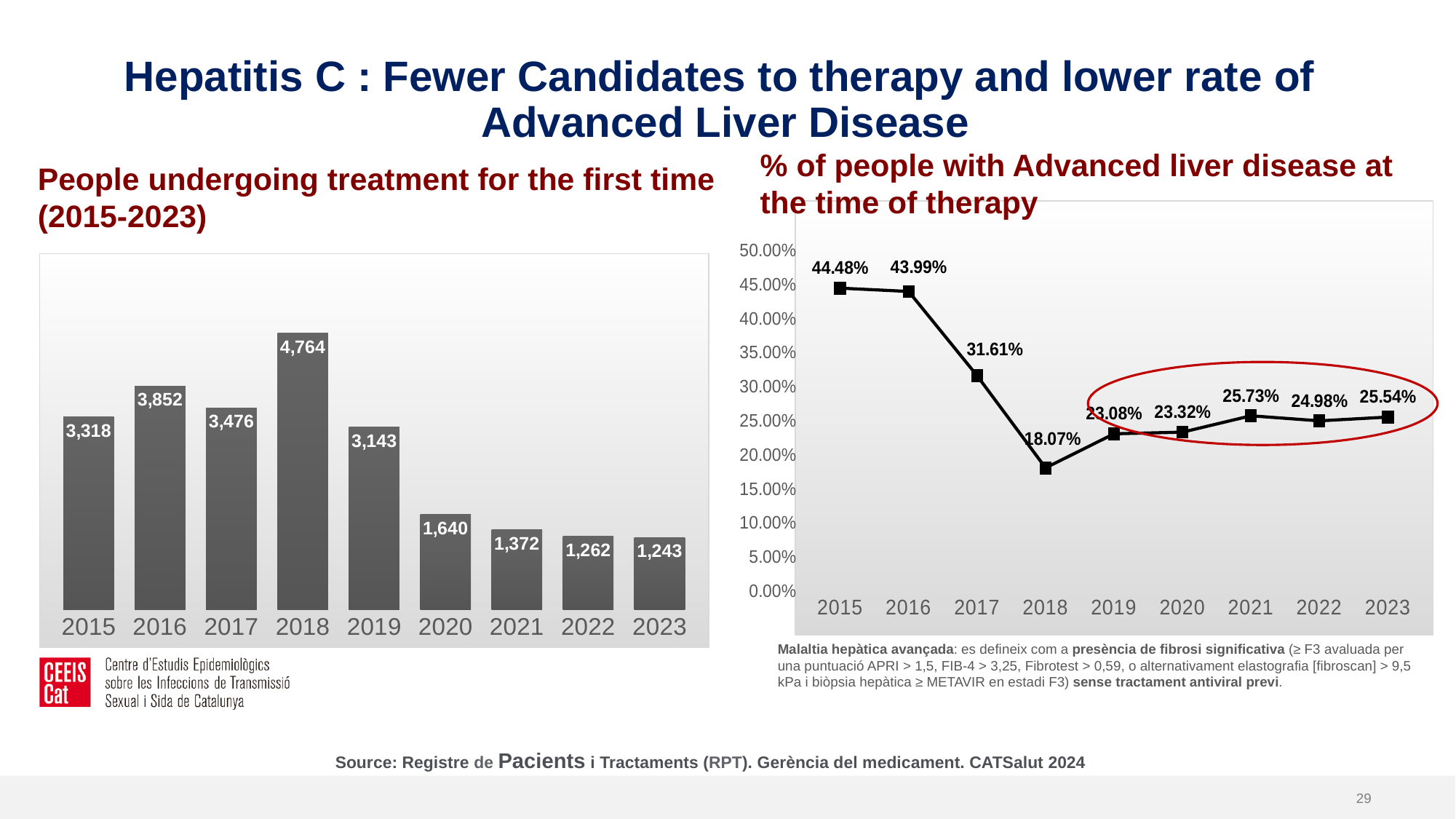
In the 'People undergoing treatment for the first time (2015-2023)' chart, which year has the highest value? 2018 In the '% of people with Advanced liver disease at the time of therapy' chart, do the values rise or fall from 2015 to 2018? Fall What kind of chart is the 'People undergoing treatment for the first time (2015-2023)' chart? Bar chart What kind of chart is the '% of people with Advanced liver disease at the time of therapy' chart? Line chart In the '% of people with Advanced liver disease at the time of therapy' chart, what is the value for 2018? 18.07% In the '% of people with Advanced liver disease at the time of therapy' chart, is the value for 2021 greater or less than the value for 2022? greater In the 'People undergoing treatment for the first time (2015-2023)' chart, what is the difference between the 2019 and 2020 values? 1,503 In the '% of people with Advanced liver disease at the time of therapy' chart, which year has the highest value? 2015 In the 'People undergoing treatment for the first time (2015-2023)' chart, how many years are shown on the x axis? 9 In the '% of people with Advanced liver disease at the time of therapy' chart, which year has the lowest value? 2018 In the 'People undergoing treatment for the first time (2015-2023)' chart, how many people underwent treatment for the first time in 2018? 4,764 In the 'People undergoing treatment for the first time (2015-2023)' chart, which year has the lowest value? 2023